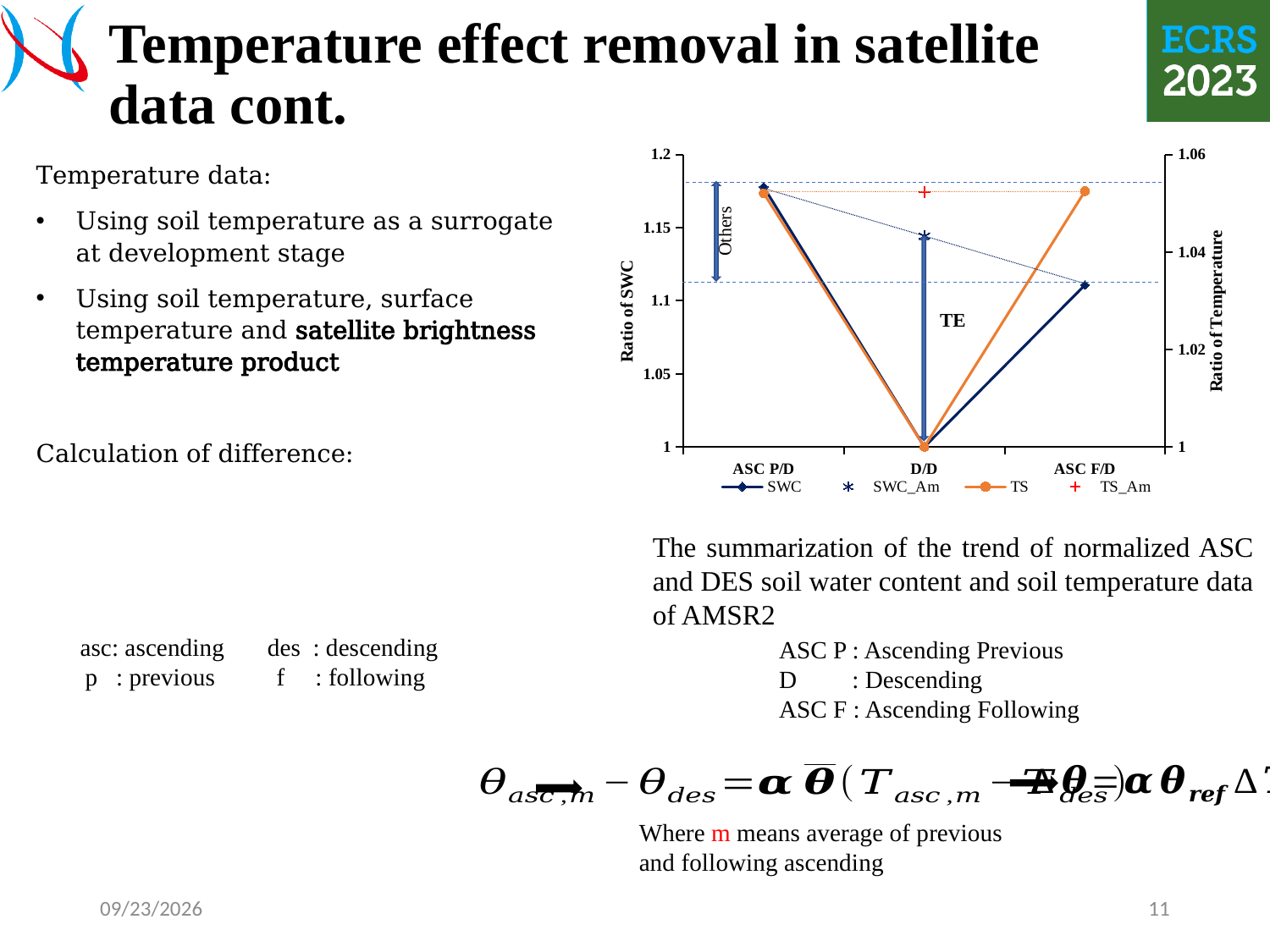
Is the value of the SWC series at ASC P/D greater or less than 1.15? greater How many categories are shown on the x axis of the chart? 3 What kind of chart is shown on the slide? line chart Does the SWC series rise or fall from ASC P/D to D/D? fall How many series does the chart legend list? 4 Which series are listed in the chart legend? SWC, SWC_Am, TS, TS_Am At which category is the SWC series lowest? D/D Is the value of the SWC series at ASC F/D greater or less than 1.15? less At which category is the SWC series highest? ASC P/D What is the value of the SWC series at D/D? 1 What is the title of the left vertical axis of the chart? Ratio of SWC Which is larger for the SWC series: the value at ASC P/D or the value at ASC F/D? ASC P/D